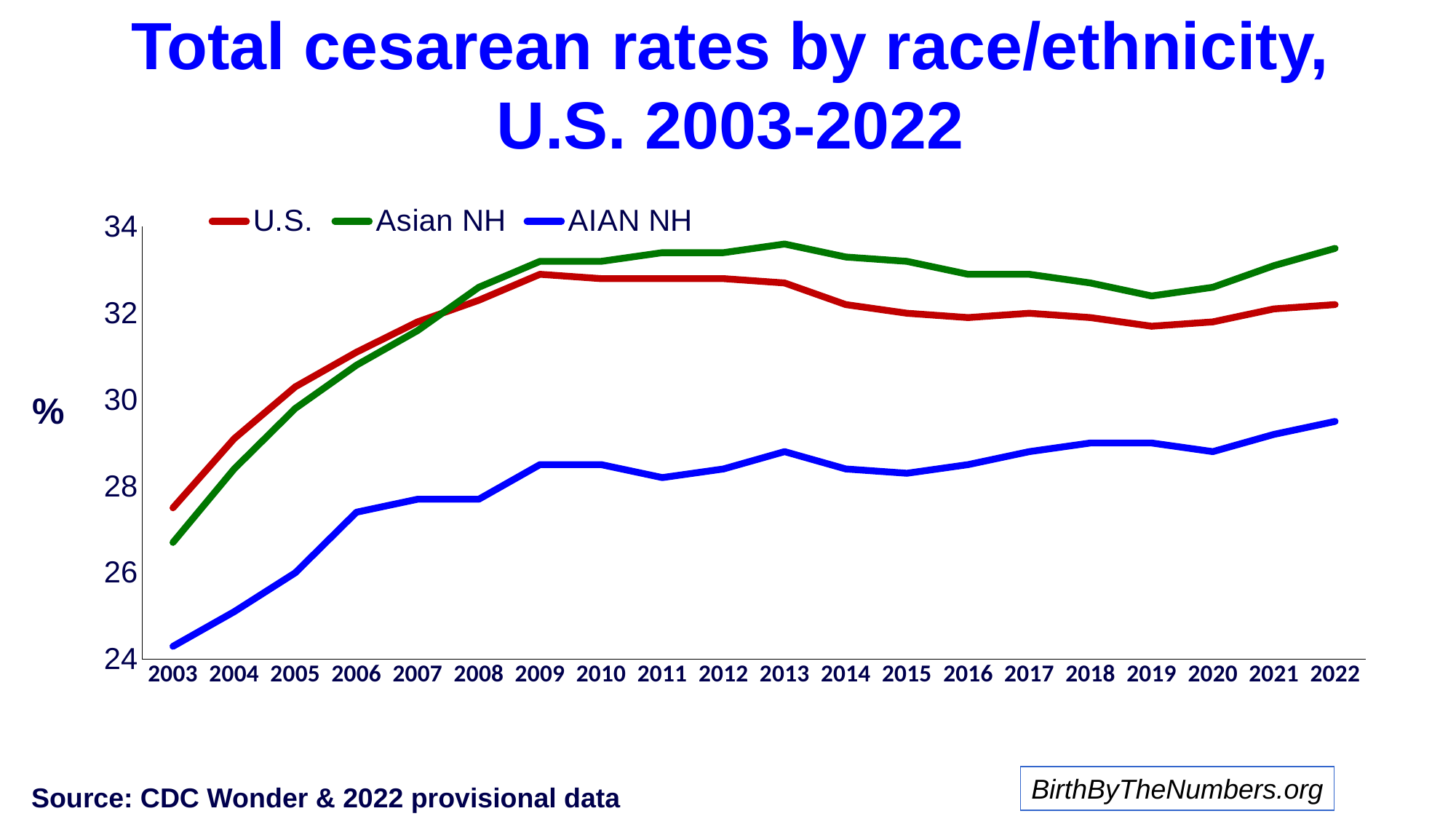
How many years are plotted along the x axis? 20 In which year is the U.S. series at its lowest? 2003 Does the AIAN NH series rise or fall from 2003 to 2009? Rise Which series has the lowest value in 2010? AIAN NH What kind of chart is shown on the slide? Line chart Is the value for AIAN NH in 2022 greater or less than 30? less Which series has the highest value in 2022? Asian NH Is the value for Asian NH in 2022 greater or less than 32? greater Is the value for AIAN NH in 2003 greater or less than 26? less How many series does the legend list? 3 In 2003, which is larger: the U.S. value or the Asian NH value? U.S.